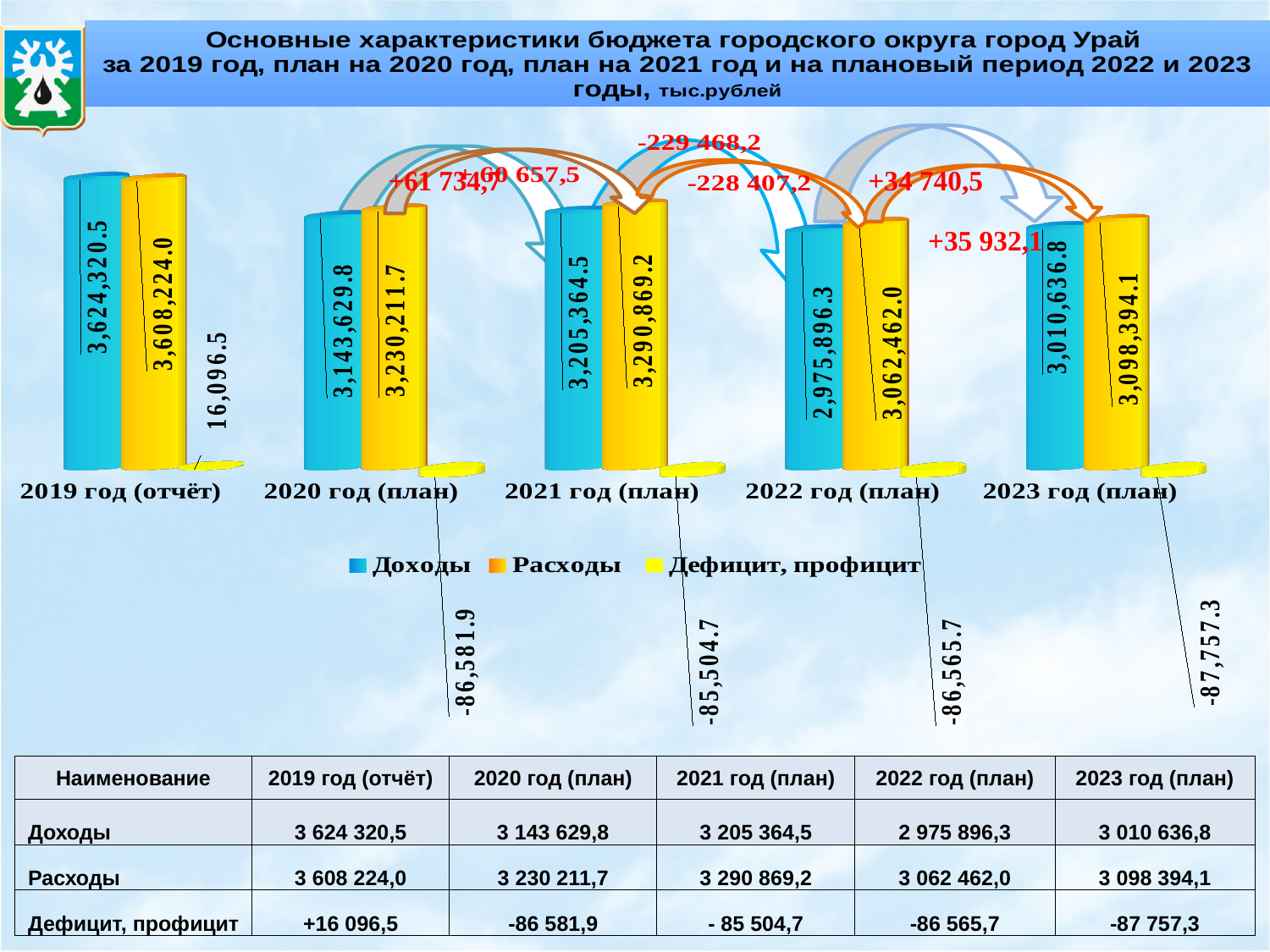
What is the value of Доходы for 2019 год (отчёт)? 3,624,320.5 What is the value of Доходы for 2022 год (план)? 2,975,896.3 Which series is shown in yellow in the legend? Дефицит, профицит What is the value of Расходы for 2021 год (план)? 3,290,869.2 What kind of chart is shown on the slide? Bar chart Which year has the lowest value of Расходы? 2022 год (план) Which is larger in 2020 год (план): Доходы or Расходы? Расходы Which year has the highest value of Доходы? 2019 год (отчёт) What is the difference between Расходы and Доходы for 2022 год (план)? 86,565.7 What is the value of Дефицит, профицит for 2023 год (план)? -87,757.3 How many year categories are shown on the chart? 5 How many series does the legend list? 3